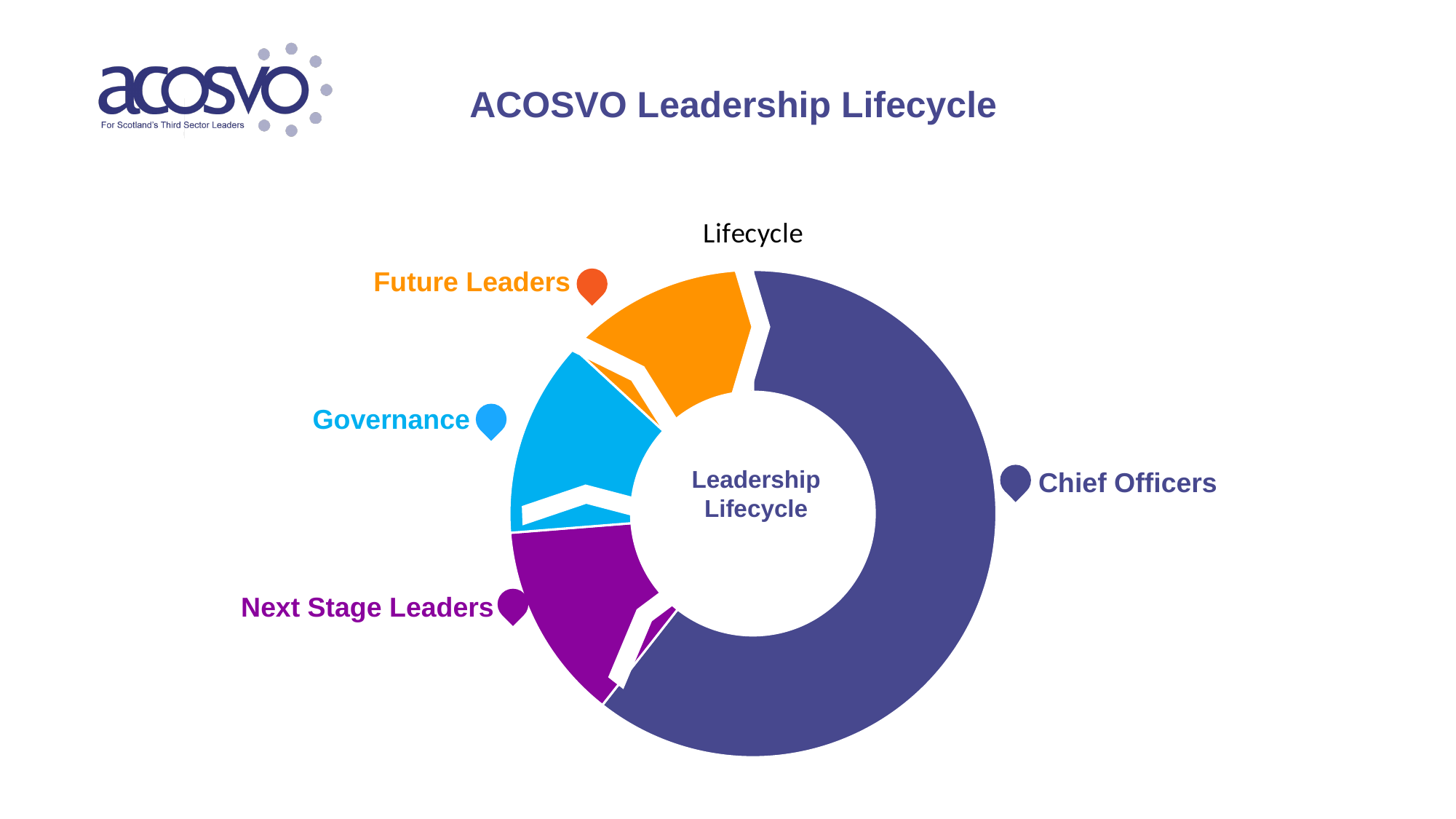
Which is larger, the Chief Officers segment or the Governance segment? Chief Officers What is the title of the chart? Lifecycle What kind of chart is shown on the slide? Doughnut chart What text appears in the centre of the doughnut chart? Leadership Lifecycle Is the share of the chart taken by Chief Officers greater or less than half? greater Which is larger, the Chief Officers segment or the Future Leaders segment? Chief Officers Which segment is the largest in the chart? Chief Officers How many segments does the chart have? 4 What colour is the Future Leaders segment? Orange